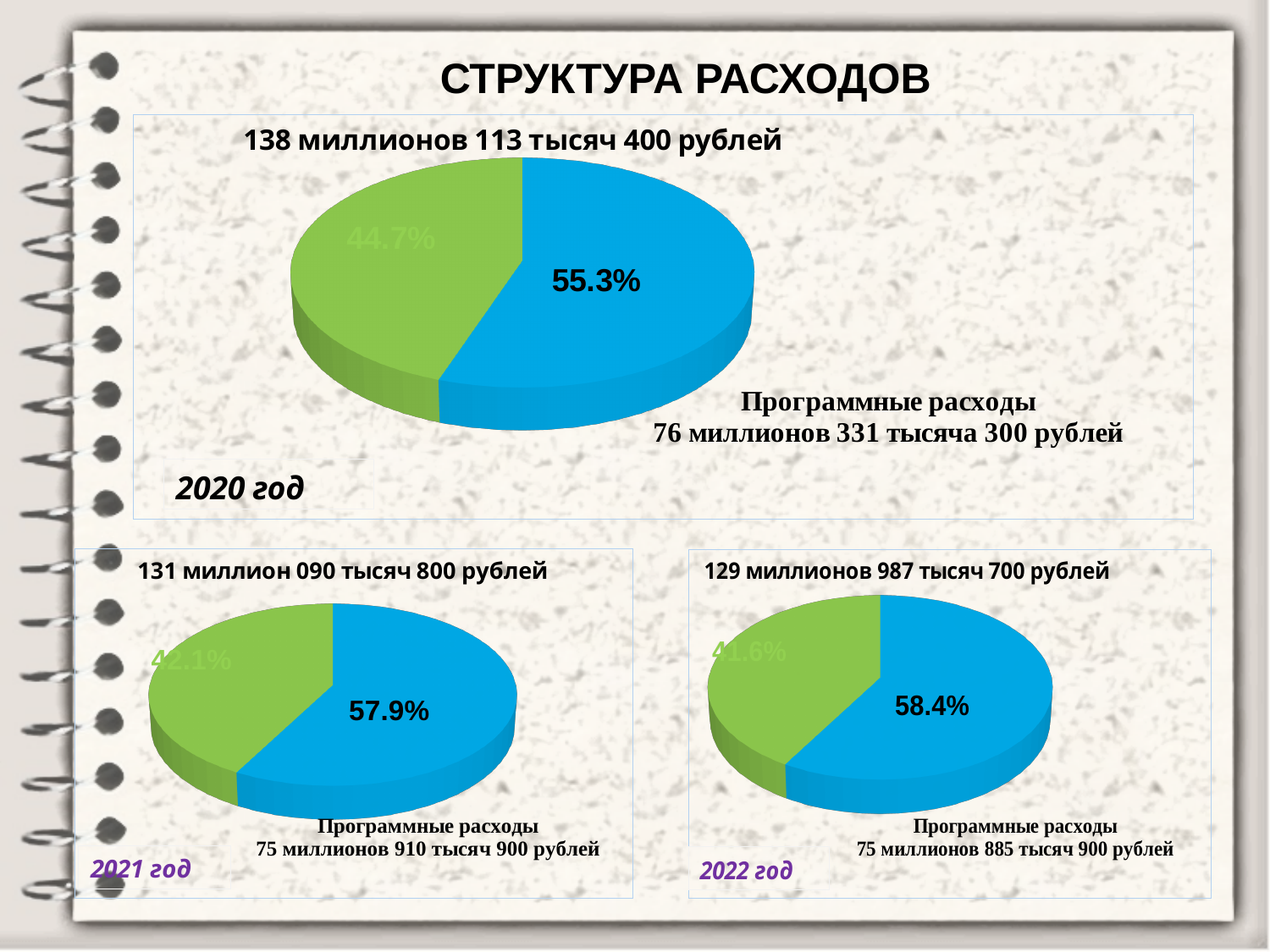
How many pie charts are shown on the slide? 3 What is the title of the slide containing the pie charts? СТРУКТУРА РАСХОДОВ Which chart shows the larger blue slice, the 2020 год chart or the 2022 год chart? the 2022 год chart In the 2021 год pie chart, which slice is larger, the blue one or the green one? the blue one In the 2022 год pie chart, what percentage is shown on the blue slice? 58.4% In the 2020 год pie chart, what percentage is shown on the blue slice? 55.3% In the 2022 год pie chart, what percentage is shown on the green slice? 41.6% How many slices does the 2022 год pie chart have? 2 In the 2020 год pie chart, what is the difference in percentage points between the blue slice and the green slice? 10.6 In the 2021 год pie chart, what percentage is shown on the blue slice? 57.9% In the 2020 год pie chart, what percentage is shown on the green slice? 44.7% What kind of chart is used for the 2020 год chart? pie chart